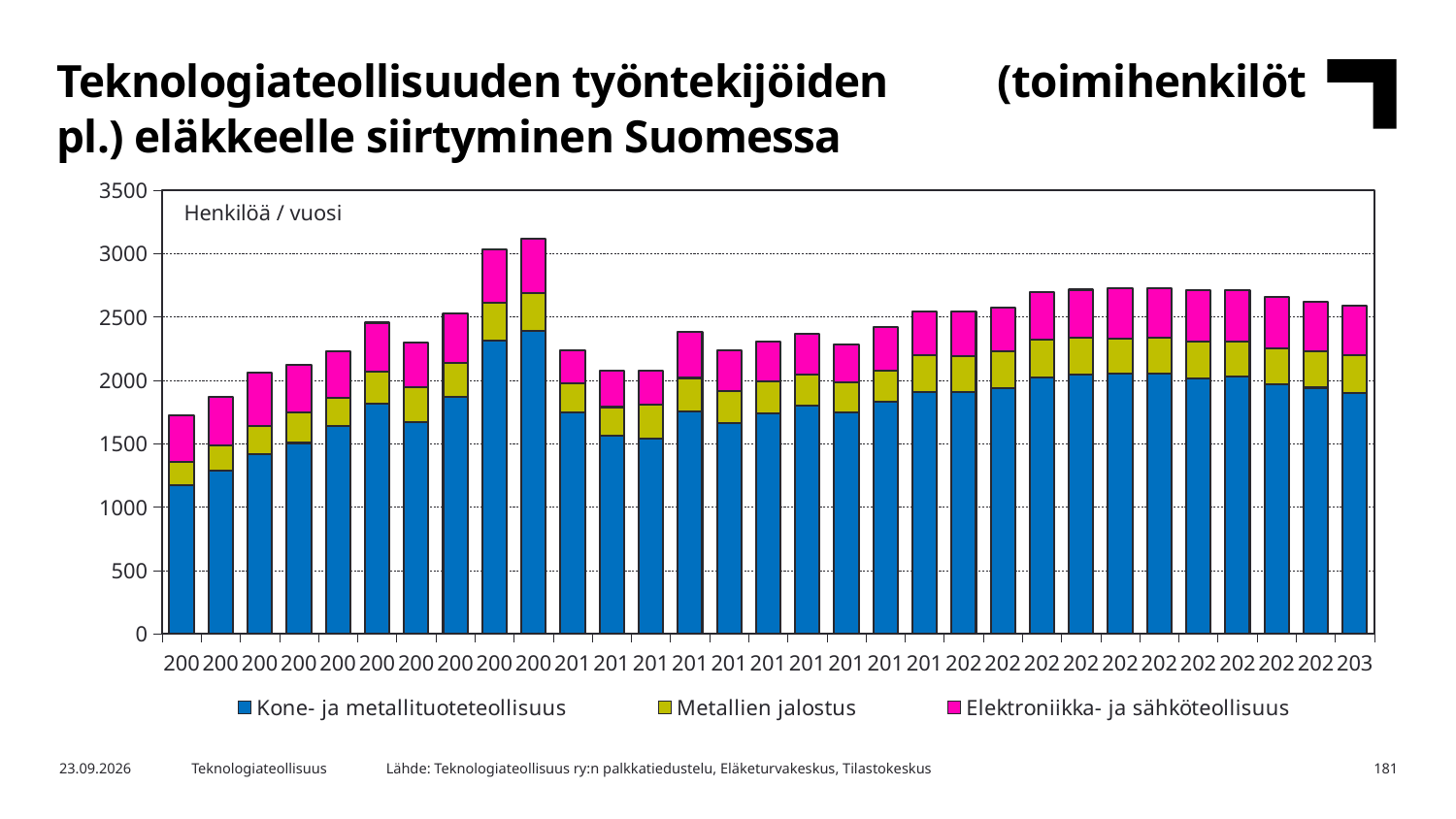
How many stacked bars are plotted in the chart? 31 Is the total of the leftmost bar greater or less than 2000? less Which series forms the bottom segment of each stacked bar? Kone- ja metallituoteteollisuus What unit label is printed inside the plot area at the top left? Henkilöä / vuosi Is the Kone- ja metallituoteteollisuus segment of the leftmost bar greater or less than 1500? less How many series does the legend list? 3 Is the total of the rightmost bar greater or less than 2500? greater What kind of chart is shown on the slide? Stacked bar chart Which series does the legend list first? Kone- ja metallituoteteollisuus Which bar has the larger total, the leftmost bar or the rightmost bar? The rightmost bar In the leftmost bar, which segment is larger: Kone- ja metallituoteteollisuus or Metallien jalostus? Kone- ja metallituoteteollisuus